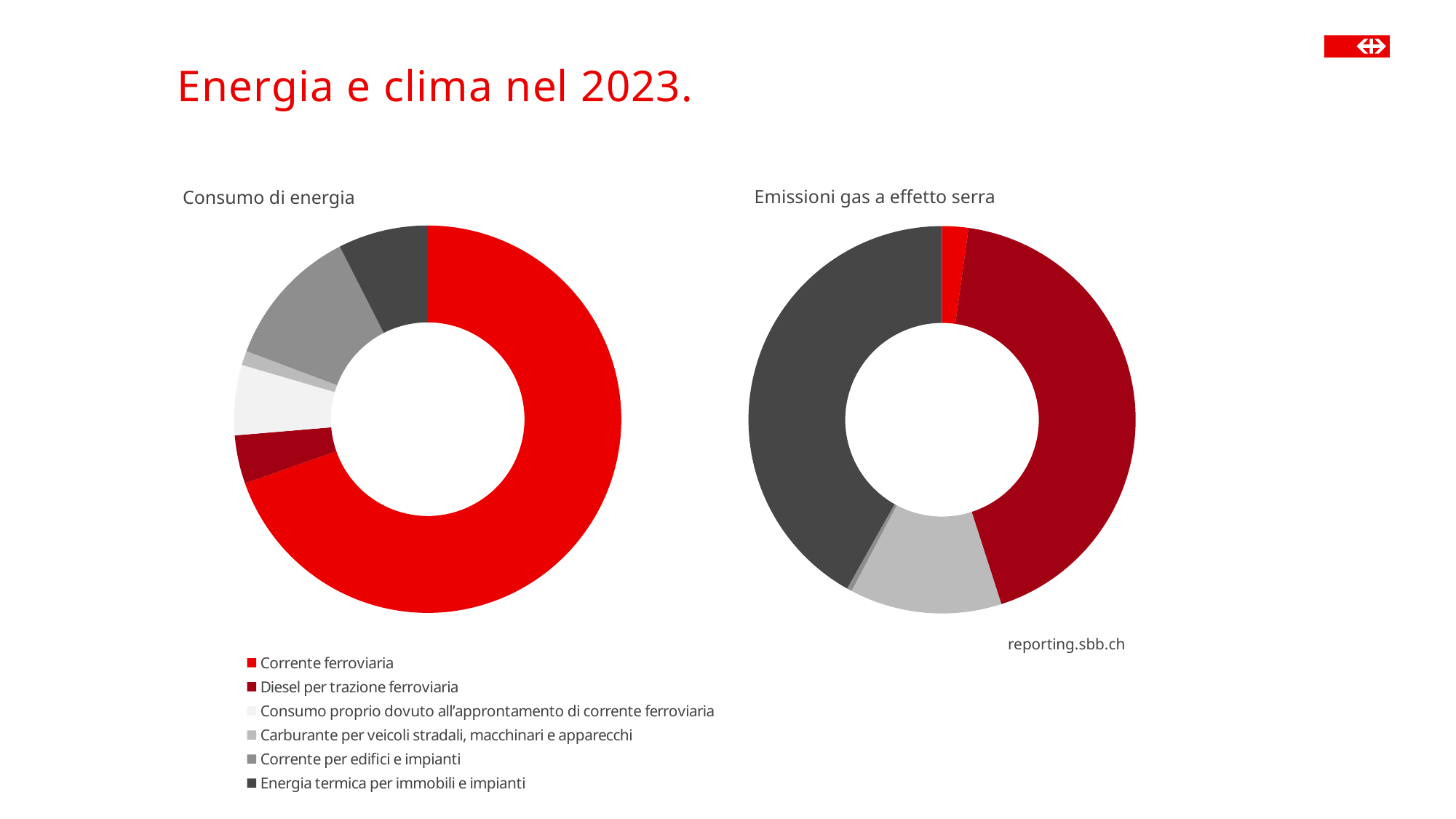
In the "Consumo di energia" chart, which is larger: Corrente per edifici e impianti or Diesel per trazione ferroviaria? Corrente per edifici e impianti What kind of chart is the "Emissioni gas a effetto serra" chart? Pie chart (donut) In the "Emissioni gas a effetto serra" chart, which is larger: Diesel per trazione ferroviaria or Corrente ferroviaria? Diesel per trazione ferroviaria How many categories does the legend list for the charts? 6 In the "Consumo di energia" chart, which category has the largest share? Corrente ferroviaria What kind of chart is the "Consumo di energia" chart? Pie chart (donut) In the "Consumo di energia" chart, which is larger: Corrente ferroviaria or Energia termica per immobili e impianti? Corrente ferroviaria What is the title of the chart on the right of the slide? Emissioni gas a effetto serra In the "Consumo di energia" chart, which category has the smallest share? Carburante per veicoli stradali, macchinari e apparecchi How many slices are visible in the "Consumo di energia" chart? 6 What is the title of the chart on the left of the slide? Consumo di energia